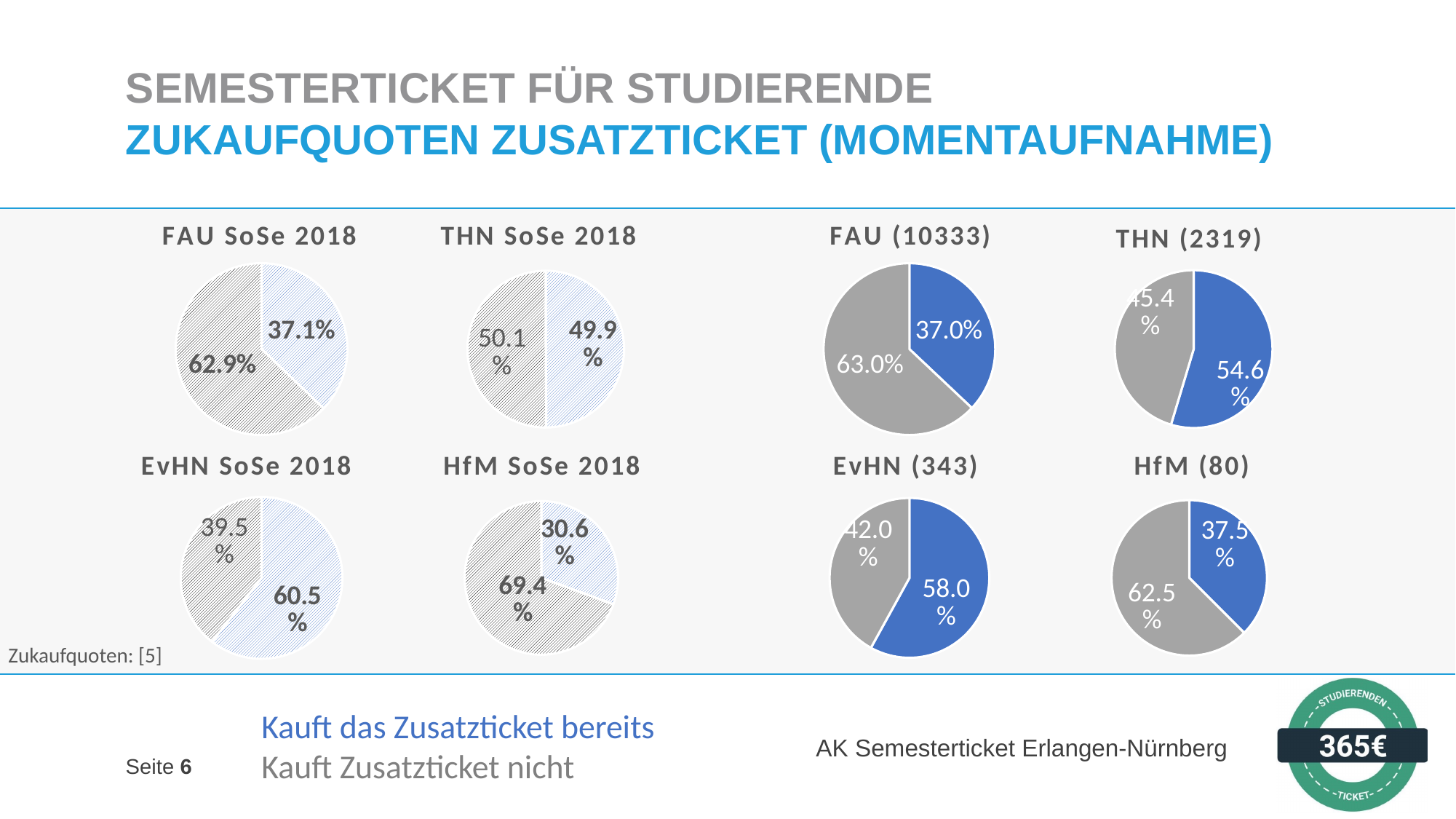
In the 'FAU (10333)' pie chart, what share of students buys the Zusatzticket already (blue slice)? 37.0% In the 'HfM SoSe 2018' pie chart, what is the larger slice's value? 69.4% In the 'FAU SoSe 2018' pie chart, what is the difference between the two slices? 25.8% In the 'HfM (80)' pie chart, is the blue slice greater or less than 50%? less In the 'THN (2319)' pie chart, what is the value of the grey slice (Kauft Zusatzticket nicht)? 45.4% How many pie charts are shown on the slide? 8 What type of chart is used for 'FAU (10333)'? pie chart In the 'EvHN (343)' pie chart, is the blue slice (Kauft das Zusatzticket bereits) greater or less than 50%? greater How many slices does the 'THN (2319)' pie chart have? 2 In the 'THN SoSe 2018' pie chart, which slice is larger, 50.1% or 49.9%? 50.1% In the 'EvHN SoSe 2018' pie chart, what is the value of the blue hatched slice? 60.5% According to the legend at the bottom of the slide, what does the blue colour represent? Kauft das Zusatzticket bereits